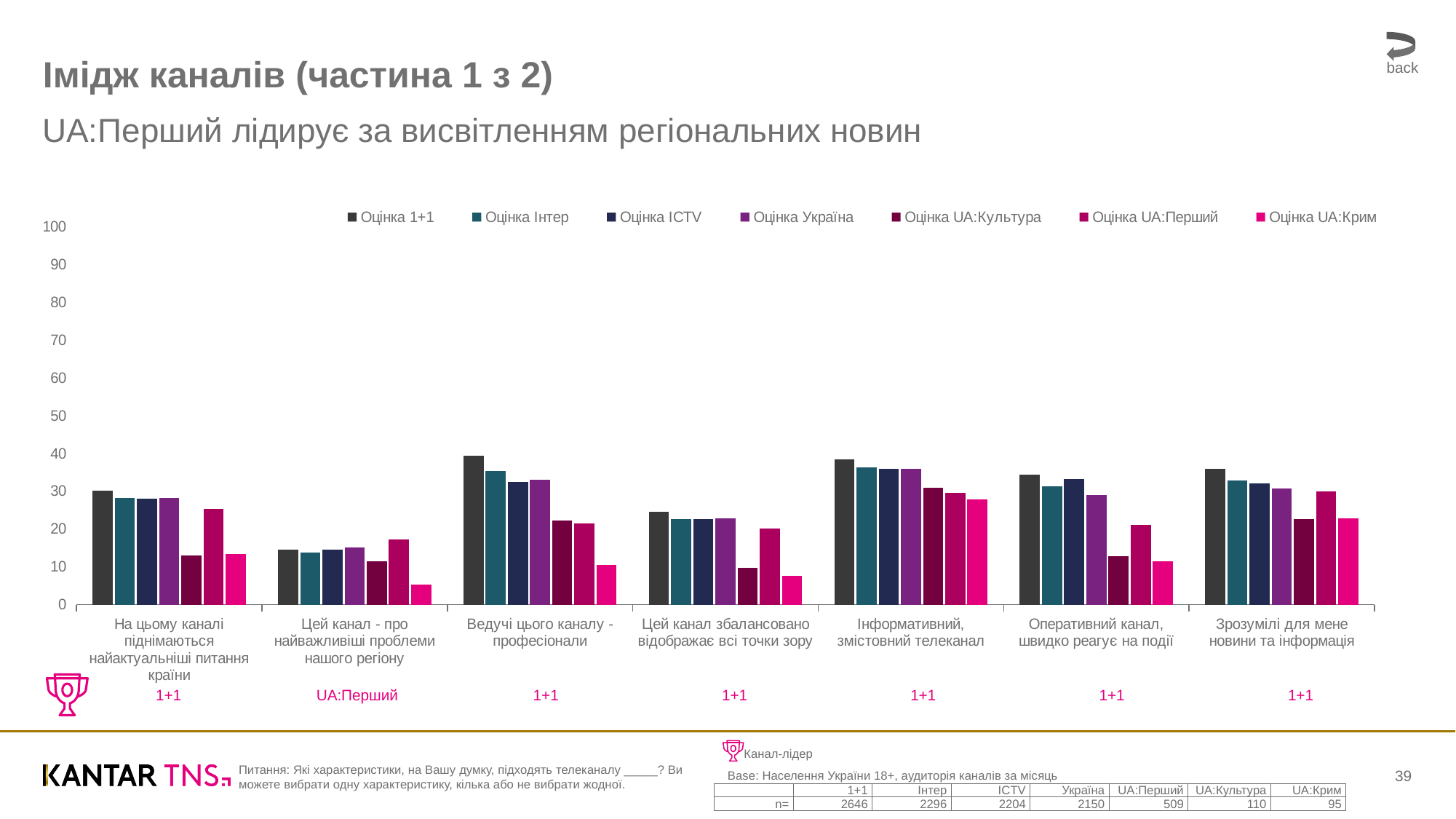
What kind of chart is shown on the slide? bar chart What is the title of the slide? Імідж каналів (частина 1 з 2) How many categories (statements) are shown along the x axis? 7 Is the value of Оцінка 1+1 for "Ведучі цього каналу - професіонали" greater or less than 30? greater Is the value of Оцінка UA:Крим for "Інформативний, змістовний телеканал" greater or less than 20? greater Which series has the lowest value for "Ведучі цього каналу - професіонали"? Оцінка UA:Крим For "На цьому каналі піднімаються найактуальніші питання країни", which is larger: Оцінка UA:Перший or Оцінка UA:Крим? Оцінка UA:Перший Which channel is marked as the leader (Канал-лідер) for "Цей канал - про найважливіші проблеми нашого регіону"? UA:Перший How many series does the legend list? 7 For "Оперативний канал, швидко реагує на події", which is larger: Оцінка ICTV or Оцінка Україна? Оцінка ICTV Is the value of Оцінка UA:Крим for "Цей канал - про найважливіші проблеми нашого регіону" greater or less than 10? less Which series has the highest value for "Цей канал - про найважливіші проблеми нашого регіону"? Оцінка UA:Перший